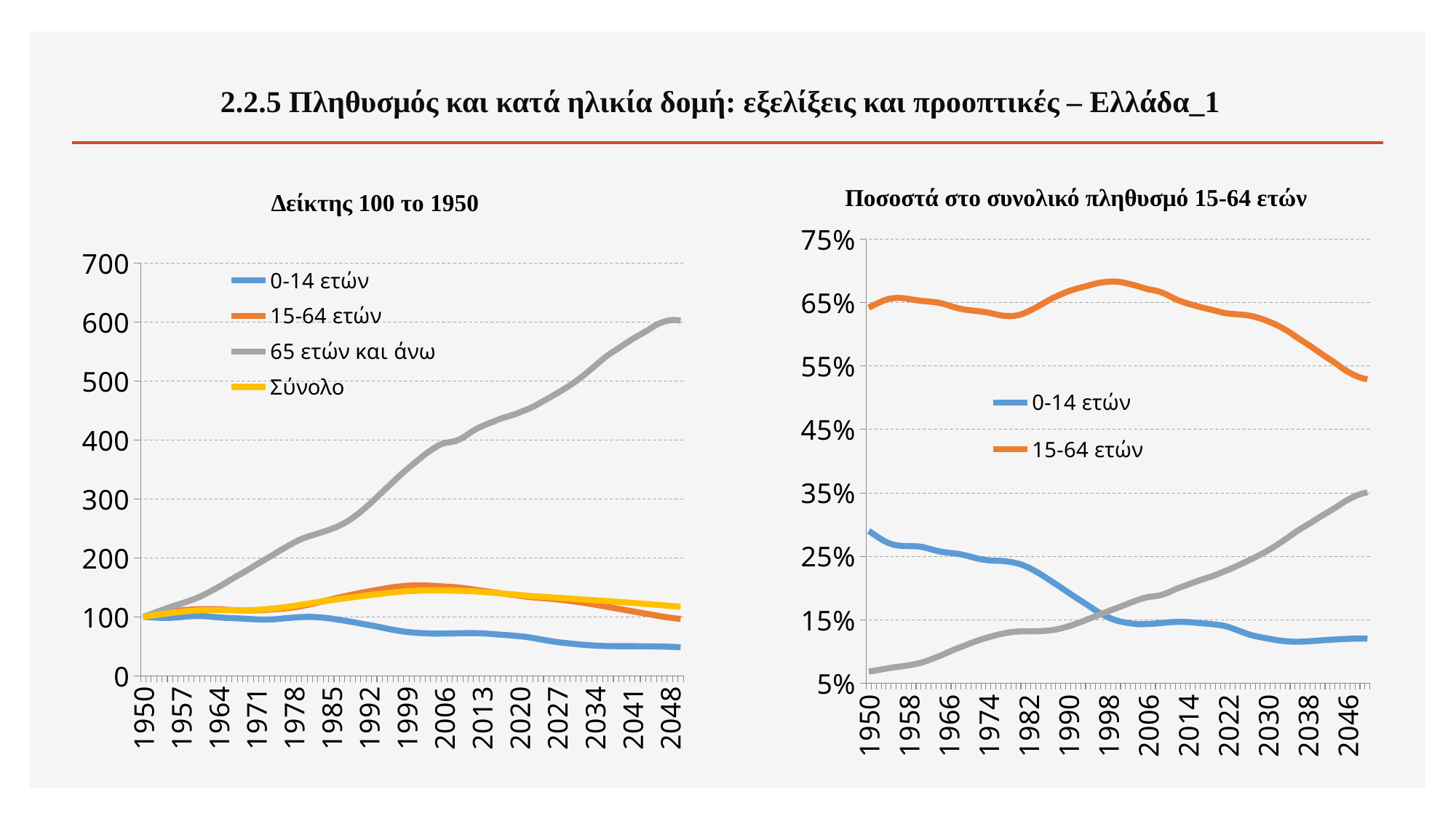
What kind of chart is the chart titled "Δείκτης 100 το 1950"? line chart How many series does the legend of the chart titled "Ποσοστά στο συνολικό πληθυσμό 15-64 ετών" list? 2 In the chart titled "Δείκτης 100 το 1950", is the value for "65 ετών και άνω" in 2048 greater or less than 500? greater In the chart titled "Δείκτης 100 το 1950", is the value for "0-14 ετών" in 2048 greater or less than 100? less In the chart titled "Δείκτης 100 το 1950", which series has the highest value in 2048? 65 ετών και άνω In the chart titled "Ποσοστά στο συνολικό πληθυσμό 15-64 ετών", is the value for "15-64 ετών" in 1998 greater or less than 65%? greater In the chart titled "Ποσοστά στο συνολικό πληθυσμό 15-64 ετών", which is larger in 1950: "15-64 ετών" or "0-14 ετών"? 15-64 ετών In the chart titled "Δείκτης 100 το 1950", which series has the lowest value in 2048? 0-14 ετών In the chart titled "Δείκτης 100 το 1950", which is larger in 2048: "Σύνολο" or "15-64 ετών"? Σύνολο In the chart titled "Ποσοστά στο συνολικό πληθυσμό 15-64 ετών", does the "0-14 ετών" line rise or fall from 1950 to 2046? fall In the chart titled "Δείκτης 100 το 1950", does the "65 ετών και άνω" line rise or fall from 1950 to 2048? rise How many series does the legend of the chart titled "Δείκτης 100 το 1950" list? 4